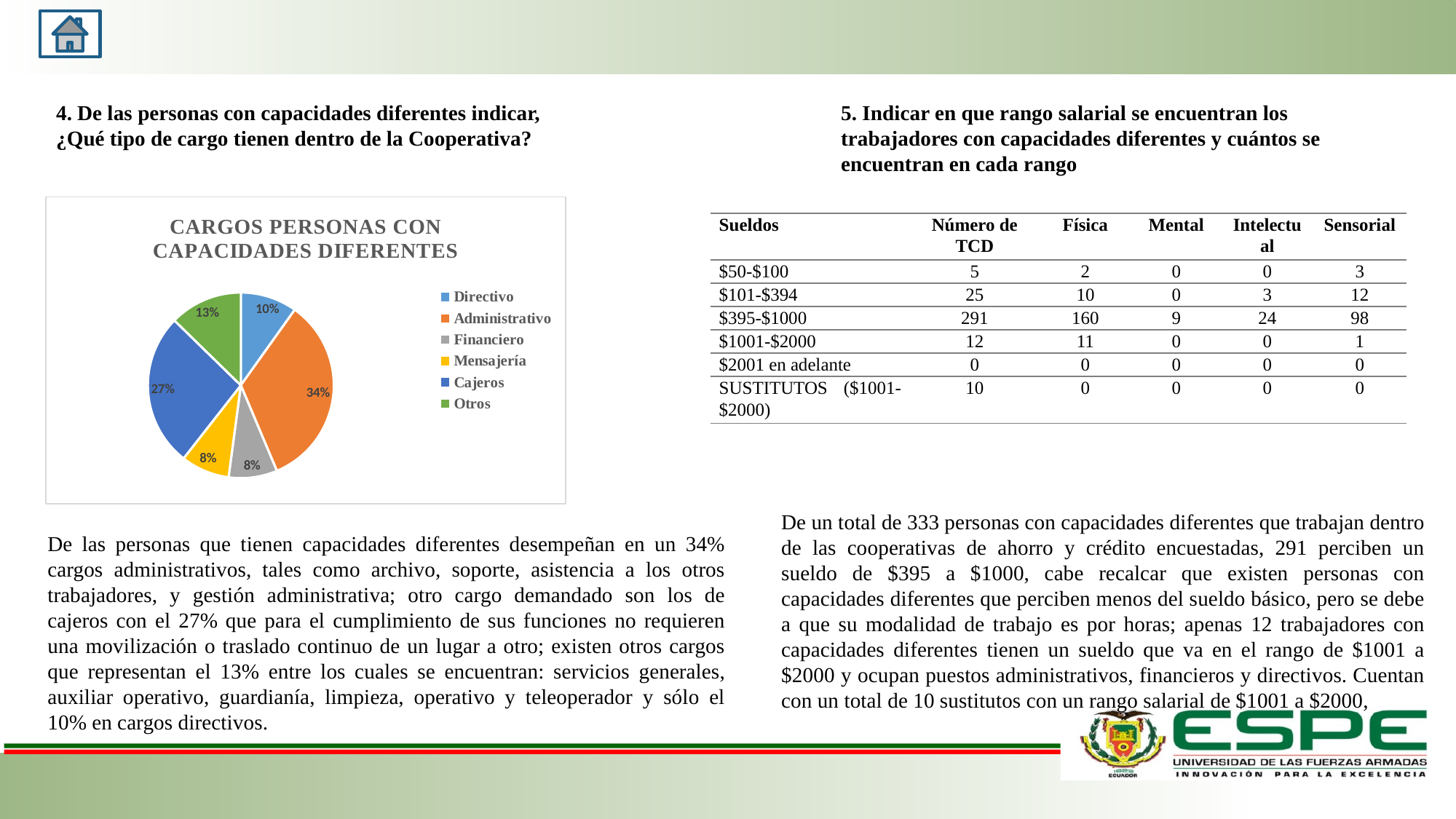
What is the title of the chart? CARGOS PERSONAS CON CAPACIDADES DIFERENTES What share of the pie does Directivo represent? 10% Which category has the largest slice of the pie? Administrativo Which colour represents Mensajería in the pie chart? yellow What type of chart is shown on the slide? pie chart What share of the pie does Cajeros represent? 27% What share of the pie does Financiero represent? 8% How many categories does the legend of the pie chart list? 6 Which is larger, the share for Cajeros or the share for Otros? Cajeros What is the difference in percentage points between Administrativo and Cajeros? 7